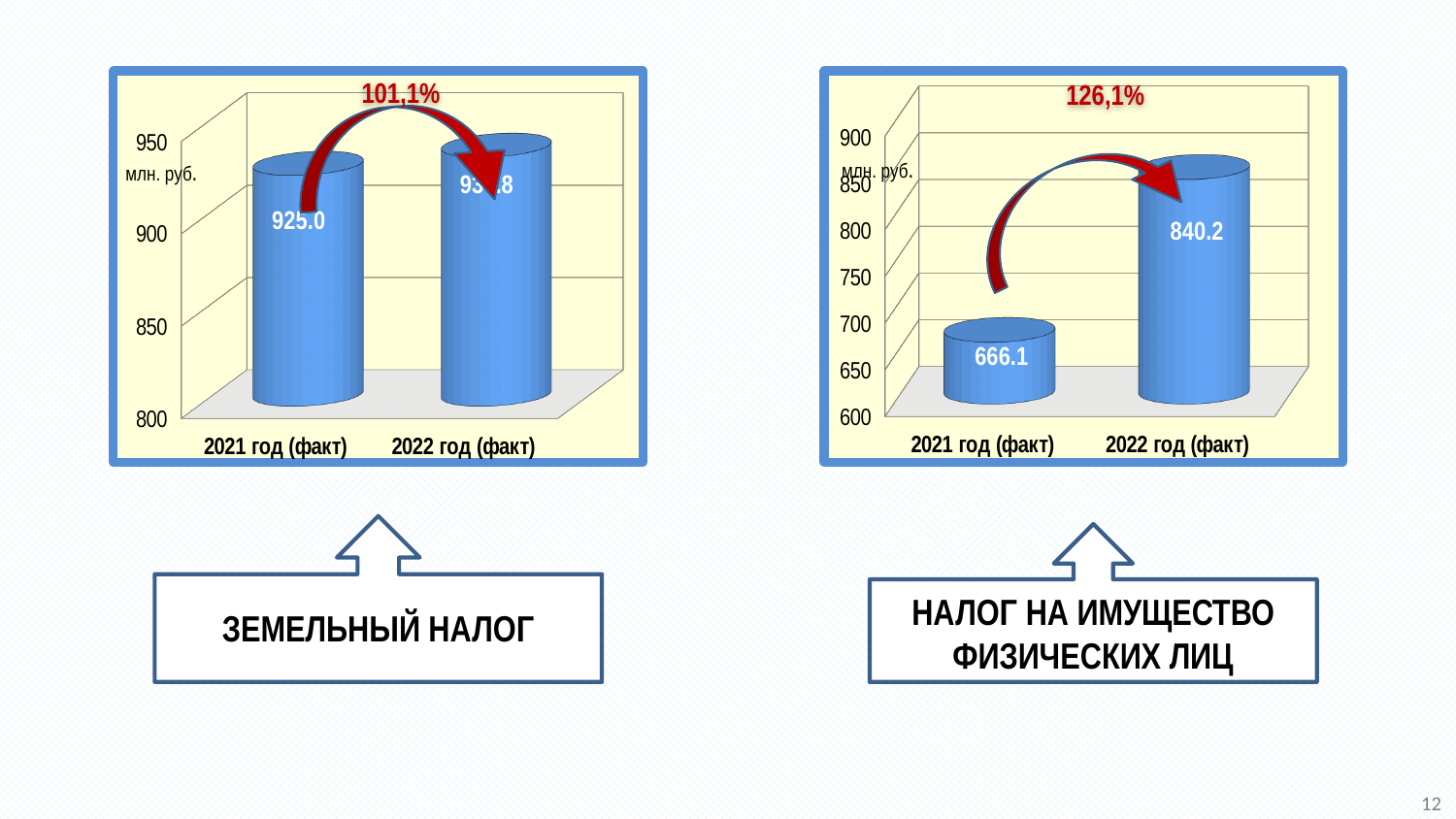
In the right chart (НАЛОГ НА ИМУЩЕСТВО ФИЗИЧЕСКИХ ЛИЦ), what is the value for 2021 год (факт)? 666.1 In the right chart (НАЛОГ НА ИМУЩЕСТВО ФИЗИЧЕСКИХ ЛИЦ), is the value for 2021 год (факт) greater or less than 700? less In the left chart (ЗЕМЕЛЬНЫЙ НАЛОГ), is the value for 2022 год (факт) greater or less than 900? greater In the right chart (НАЛОГ НА ИМУЩЕСТВО ФИЗИЧЕСКИХ ЛИЦ), which year has the higher value? 2022 год (факт) In the right chart (НАЛОГ НА ИМУЩЕСТВО ФИЗИЧЕСКИХ ЛИЦ), what is the difference between the 2022 год (факт) and 2021 год (факт) values? 174.1 What percentage is shown above the arrow in the right chart (НАЛОГ НА ИМУЩЕСТВО ФИЗИЧЕСКИХ ЛИЦ)? 126,1% In the left chart (ЗЕМЕЛЬНЫЙ НАЛОГ), which year has the lower value? 2021 год (факт) How many categories are shown on the x axis of the left chart (ЗЕМЕЛЬНЫЙ НАЛОГ)? 2 What kind of chart is the right chart (НАЛОГ НА ИМУЩЕСТВО ФИЗИЧЕСКИХ ЛИЦ)? Bar chart What unit is shown on the vertical axis of the left chart (ЗЕМЕЛЬНЫЙ НАЛОГ)? млн. руб. In the right chart (НАЛОГ НА ИМУЩЕСТВО ФИЗИЧЕСКИХ ЛИЦ), what is the value for 2022 год (факт)? 840.2 In the left chart (ЗЕМЕЛЬНЫЙ НАЛОГ), what is the value for 2021 год (факт)? 925.0